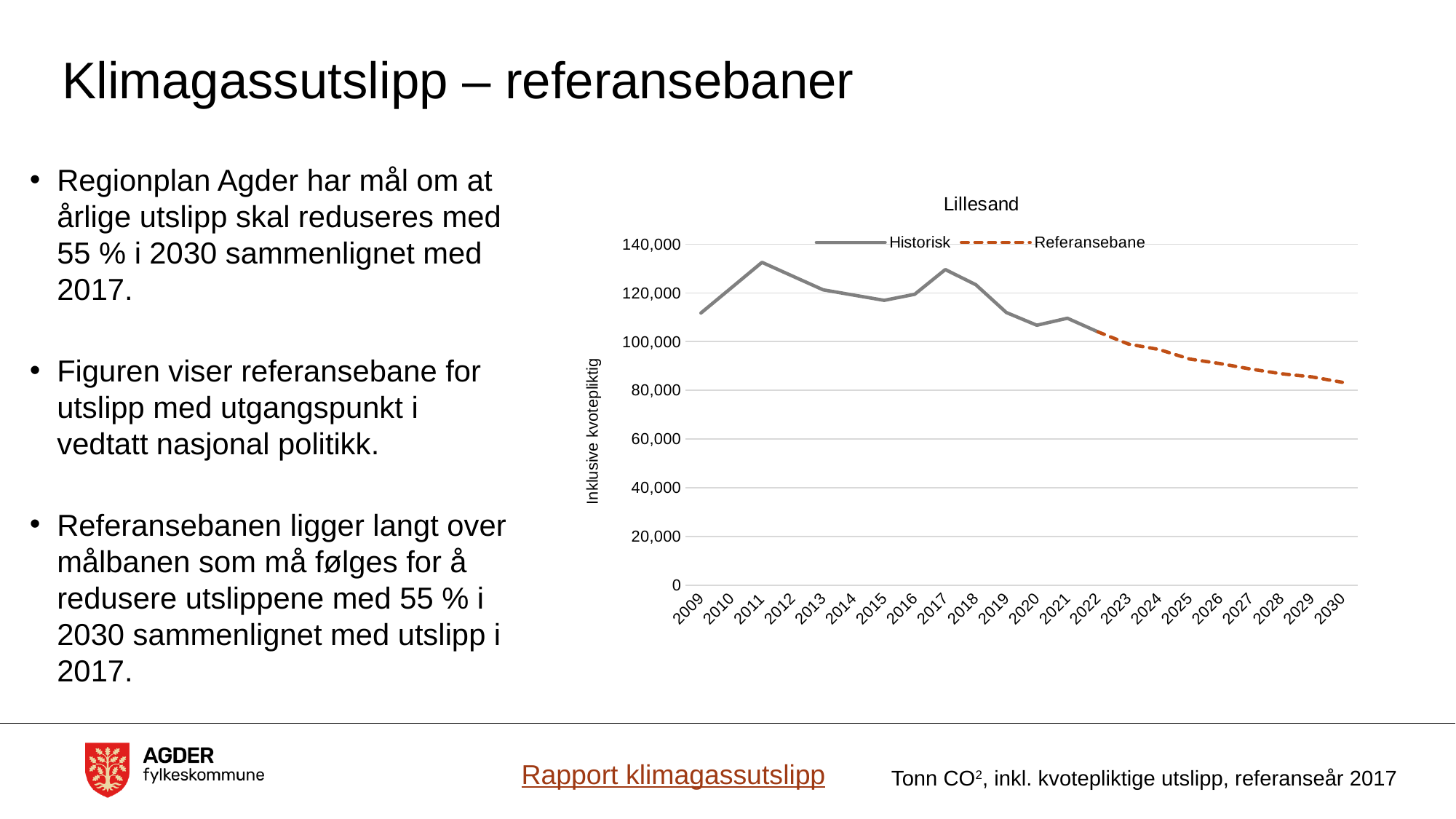
Is the value for 2020 greater or less than 100,000? greater Is the value for 2025 greater or less than 100,000? less Is the value for 2030 greater or less than 100,000? less What kind of chart is shown on the slide? Line chart How many series does the chart legend list? 2 What is the title of the chart? Lillesand Which series is drawn as a dashed line? Referansebane How many years are shown on the x axis of the chart? 22 Does the Referansebane series rise or fall from 2022 to 2030? Fall Which is larger, the value for 2009 or the value for 2011? 2011 Which year has the lowest value on the chart? 2030